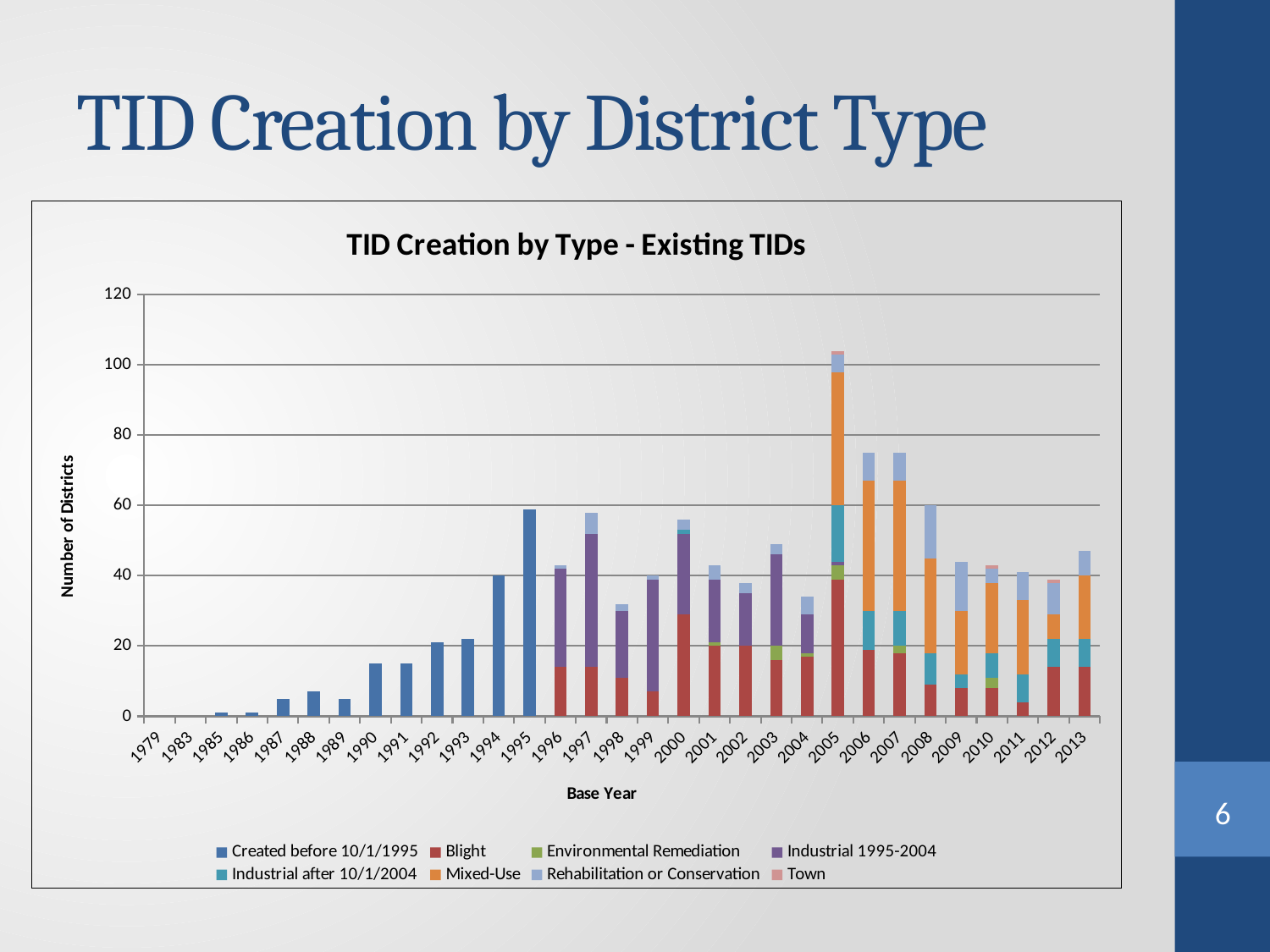
What kind of chart is shown on the slide? Stacked bar chart Is the total for 2005 greater or less than 100? greater Is the total for 1990 greater or less than 20? less What is the label of the vertical axis? Number of Districts Which has a larger total, 2005 or 2006? 2005 How many series does the legend list? 8 What is the title of the chart? TID Creation by Type - Existing TIDs Is the total for 1997 greater or less than 40? greater How many base years are shown on the x axis? 31 Which has a larger total, 1994 or 1995? 1995 Which base year has the highest total number of districts? 2005